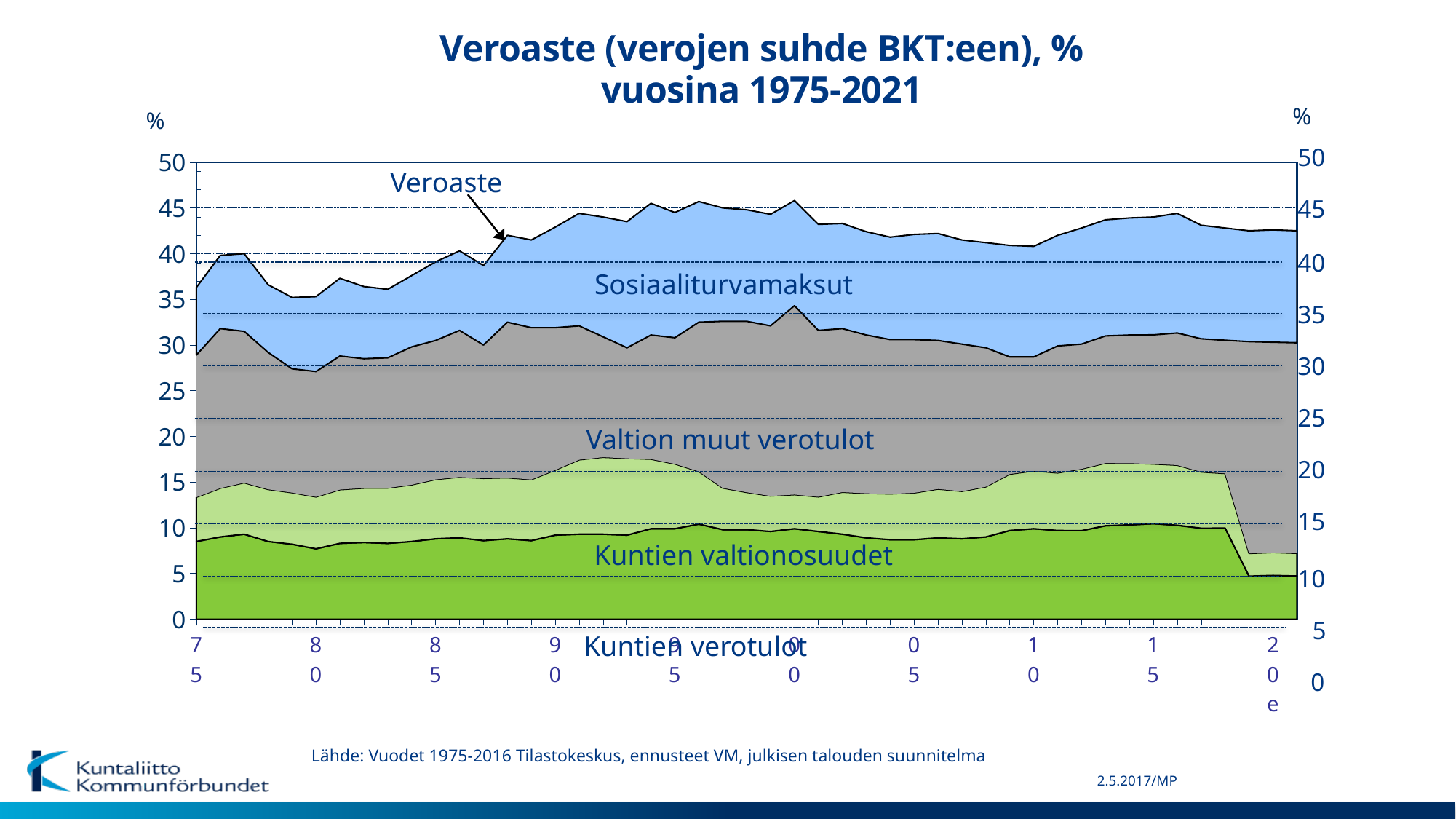
What kind of chart is shown on the slide? Stacked area chart How many year labels are shown on the x axis? 10 Which series forms the bottom (lowest) layer of the stacked areas? Kuntien verotulot Is the Veroaste value in 1990 greater or less than 40? greater Is the Kuntien verotulot value in 2020e greater or less than 10? less How many stacked area series are labelled in the chart? 4 Does the Veroaste line rise or fall between 1975 and 1990? rise Is the Veroaste value in 1975 greater or less than 40? less Is the Veroaste value in 1990 larger or smaller than in 1975? larger What is the title of the chart? Veroaste (verojen suhde BKT:een), % vuosina 1975-2021